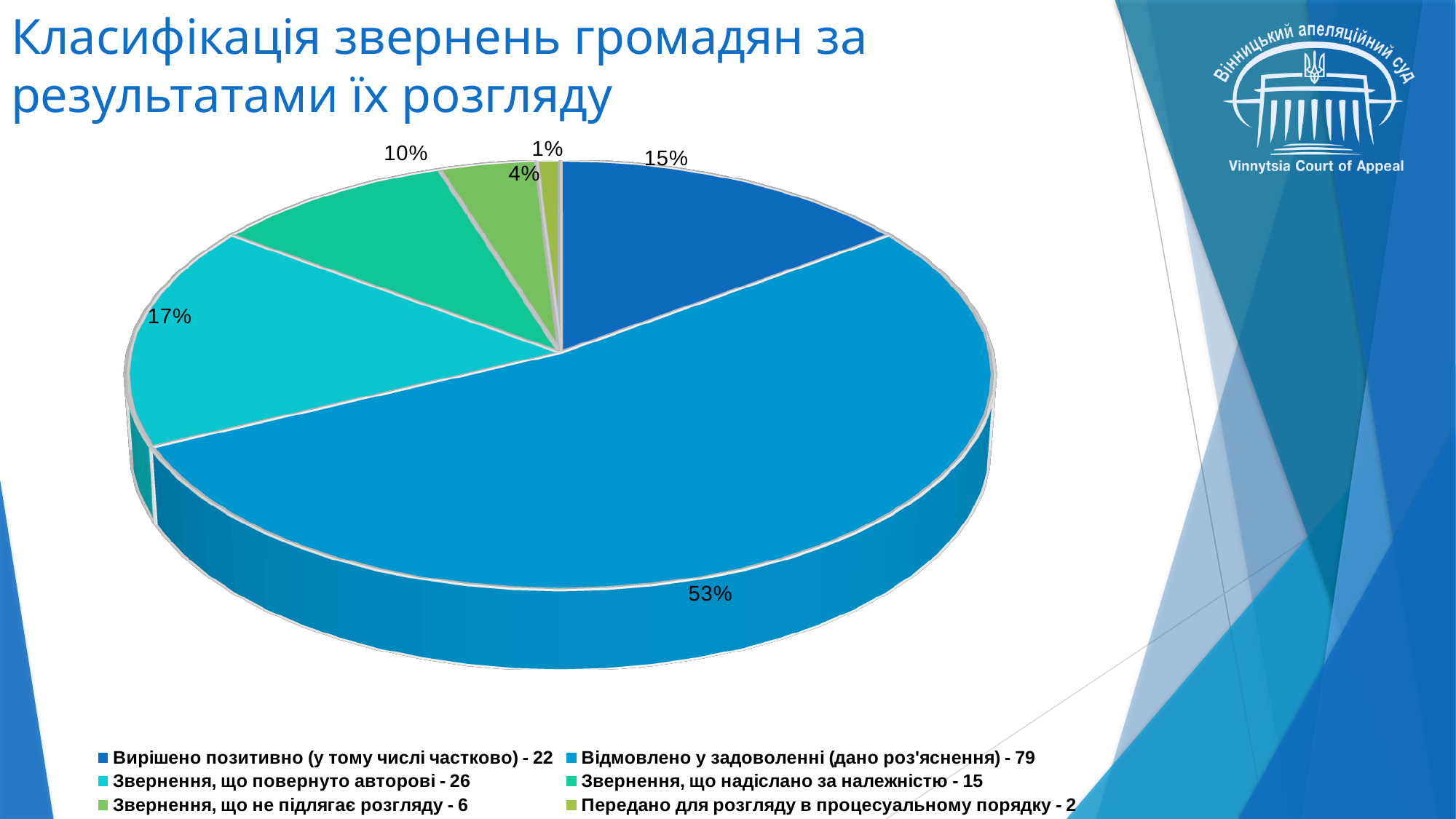
Which slice is larger: "Звернення, що не підлягає розгляду" or "Звернення, що надіслано за належністю"? Звернення, що надіслано за належністю How many categories does the pie chart show? 6 What kind of chart is shown on the slide? pie chart What percentage is shown for "Звернення, що надіслано за належністю"? 10% What percentage is shown for "Звернення, що повернуто авторові"? 17% According to the legend, how many appeals are in the category "Відмовлено у задоволенні (дано роз'яснення)"? 79 What percentage is shown for "Вирішено позитивно (у тому числі частково)"? 15% What share of the pie does "Відмовлено у задоволенні (дано роз'яснення)" take? 53% What is the difference in percentage points between the "Звернення, що повернуто авторові" slice (17%) and the "Вирішено позитивно" slice (15%)? 2 Which category has the largest slice of the pie? Відмовлено у задоволенні (дано роз'яснення) Which category has the smallest slice of the pie? Передано для розгляду в процесуальному порядку What is the title of the slide containing the pie chart? Класифікація звернень громадян за результатами їх розгляду